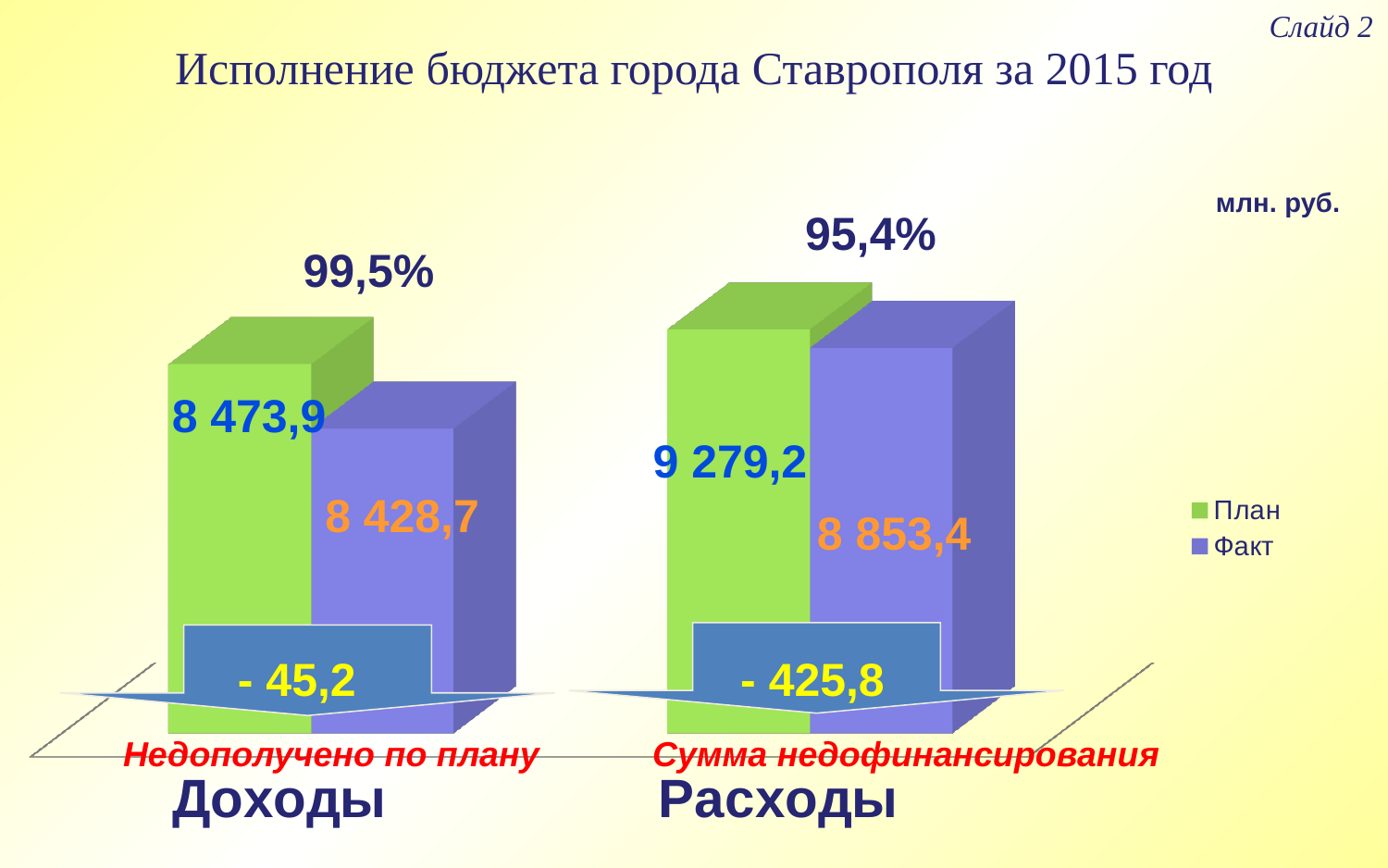
What is the План value for Доходы? 8 473,9 Which is larger for Расходы, the План value or the Факт value? План Which category has the lowest Факт value? Доходы What is the План value for Расходы? 9 279,2 What is the Факт value for Доходы? 8 428,7 What kind of chart is shown on the slide? Bar chart How many categories are shown on the chart? 2 What is the difference between the План and Факт values for Расходы? 425,8 Which category has the highest План value? Расходы What is the Факт value for Расходы? 8 853,4 What is the difference between the План and Факт values for Доходы? 45,2 How many series does the legend list? 2